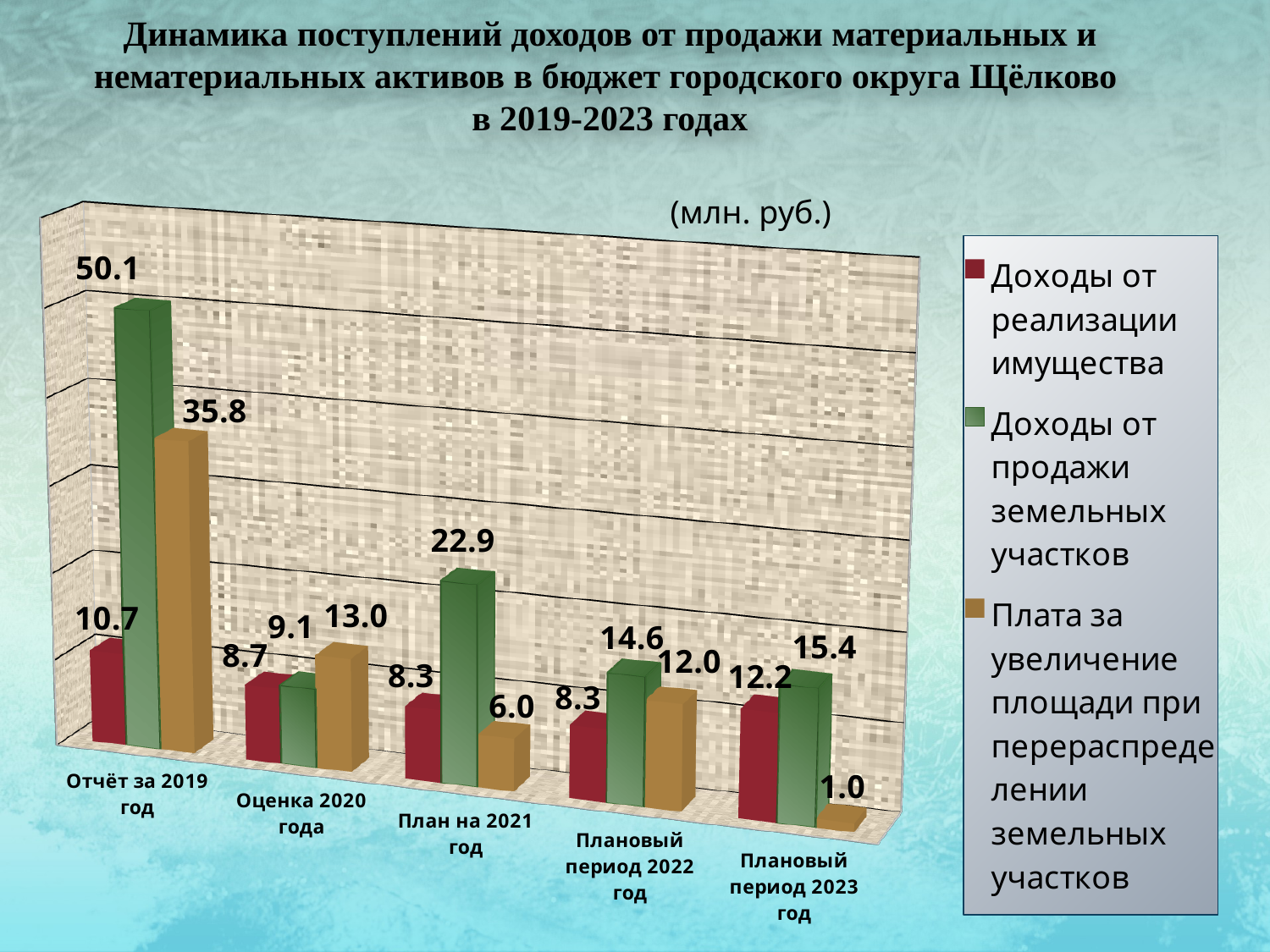
How many series does the legend list? 3 In which category is the value for 'Доходы от продажи земельных участков' highest? Отчёт за 2019 год What kind of chart is shown on the slide? Bar chart What is the value for 'Доходы от продажи земельных участков' in 'Отчёт за 2019 год'? 50.1 What unit is indicated above the chart? млн. руб. In which category is the value for 'Плата за увеличение площади при перераспределении земельных участков' lowest? Плановый период 2023 год What is the value for 'Плата за увеличение площади при перераспределении земельных участков' in 'Плановый период 2023 год'? 1.0 What is the value for 'Доходы от реализации имущества' in 'Оценка 2020 года'? 8.7 How many categories are shown on the x axis? 5 What is the value for 'Доходы от продажи земельных участков' in 'План на 2021 год'? 22.9 What is the difference between 'Доходы от продажи земельных участков' and 'Плата за увеличение площади при перераспределении земельных участков' in 'Отчёт за 2019 год'? 14.3 Which is larger in 'План на 2021 год': 'Доходы от реализации имущества' or 'Плата за увеличение площади при перераспределении земельных участков'? Доходы от реализации имущества